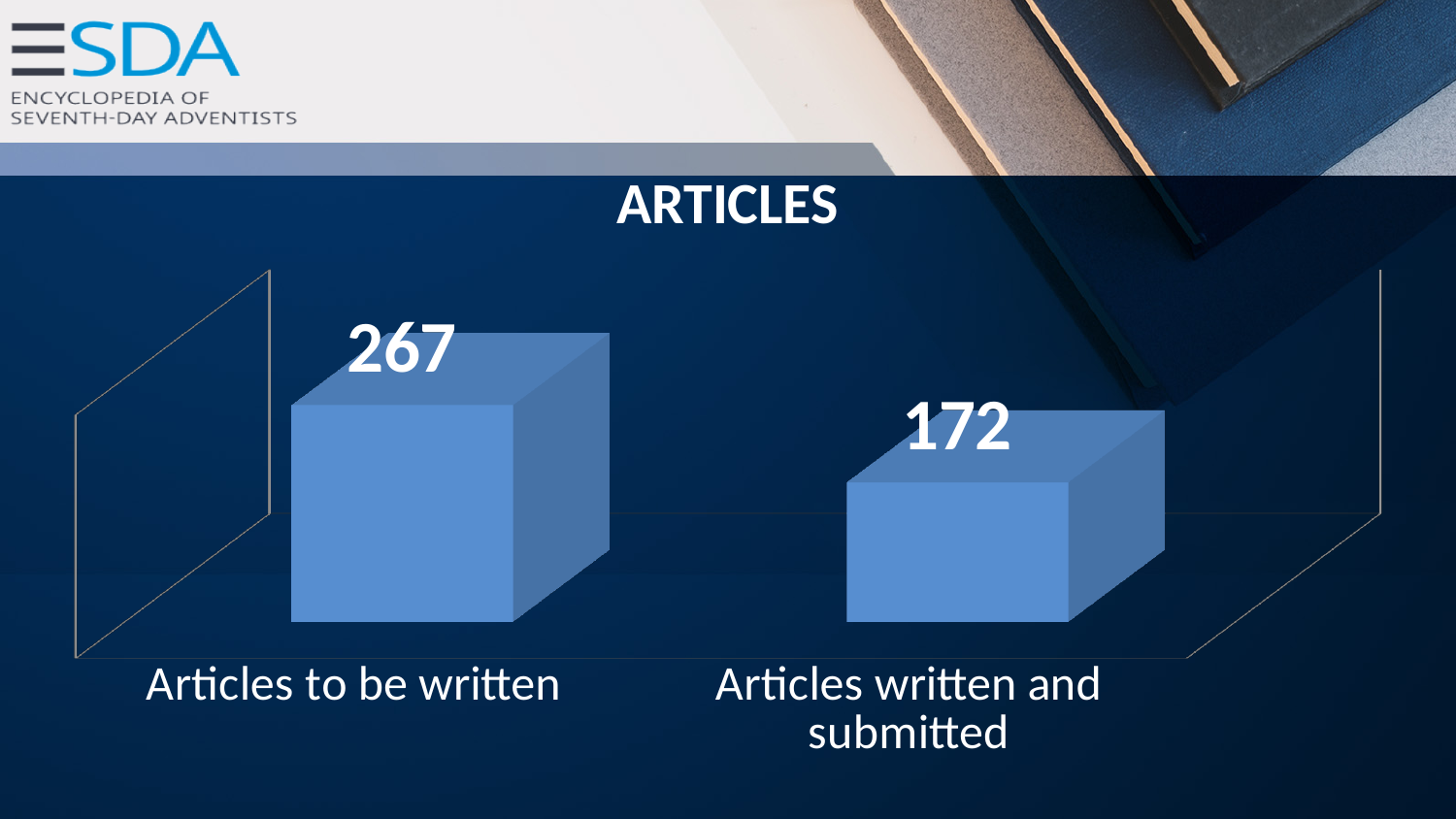
Which category has the lowest value? Articles written and submitted Which category has the highest value? Articles to be written What is the title of the chart? ARTICLES What is the combined total of the two categories shown? 439 What kind of chart is shown on the slide? Bar chart How many categories are shown in the chart? 2 Which is larger, Articles to be written or Articles written and submitted? Articles to be written What is the value for Articles to be written? 267 What is the difference between Articles to be written and Articles written and submitted? 95 Do the values rise or fall from left to right across the categories? Fall What is the value for Articles written and submitted? 172